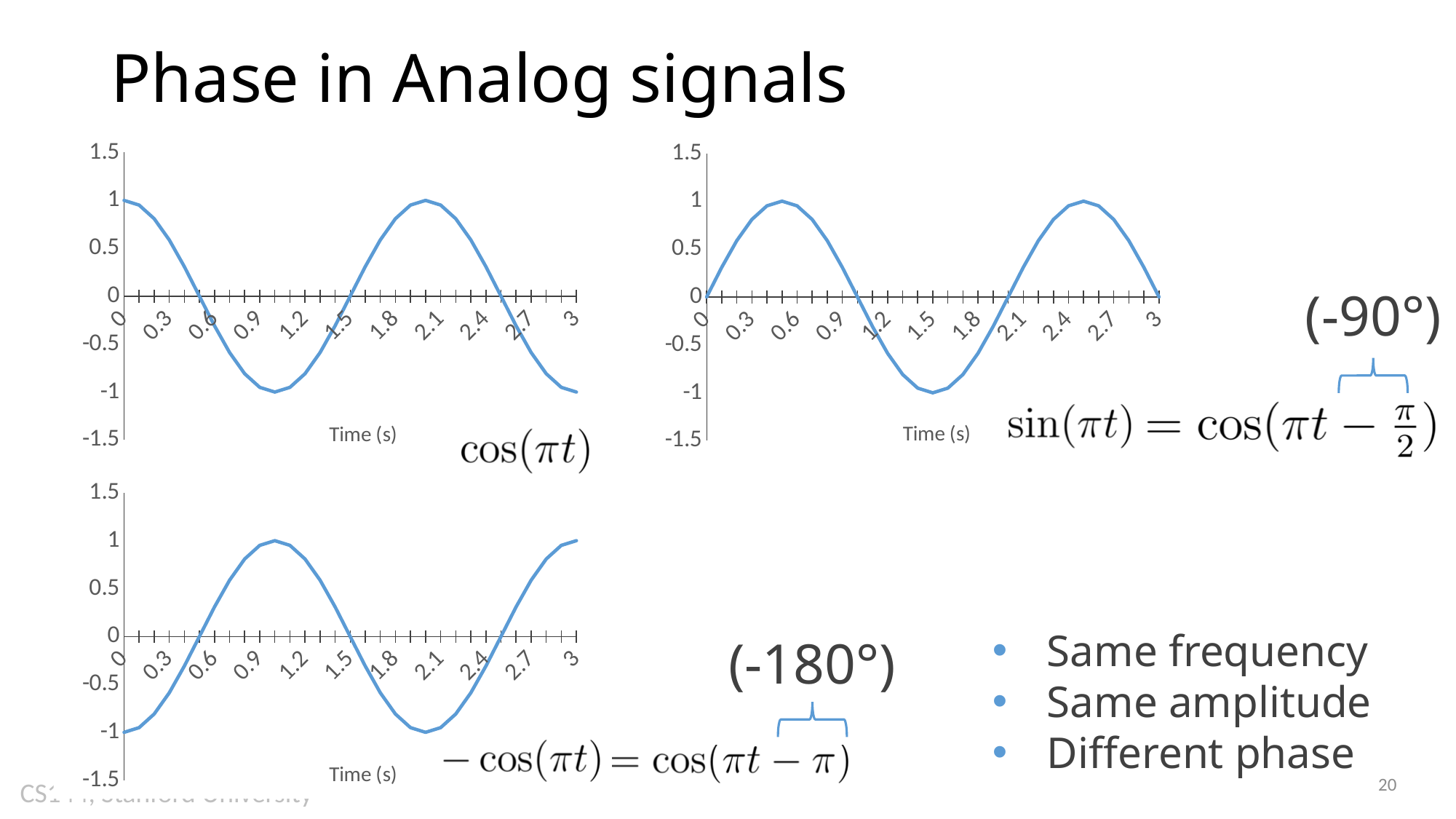
In the top-right chart, what is the value of the curve at time 0? 0 In the top-left chart, which is larger: the value at time 0 or the value at time 1? time 0 In the top-left chart, does the curve rise or fall between time 0 and time 0.9? fall In the bottom-left chart, does the curve rise or fall between time 0 and time 0.9? rise What kind of chart is the top-left chart on the slide? line chart In the top-right chart, is the value at time 0.6 greater or less than 0.5? greater In the bottom-left chart, what is the value of the curve at time 0? -1 In the bottom-left chart, is the value at time 2.1 greater or less than -0.5? less In the top-left chart, is the value at time 0.9 greater or less than -0.5? less In the top-left chart, what is the value of the curve at time 0? 1 What is the x-axis label of the bottom-left chart? Time (s) How many charts are shown on the slide? 3